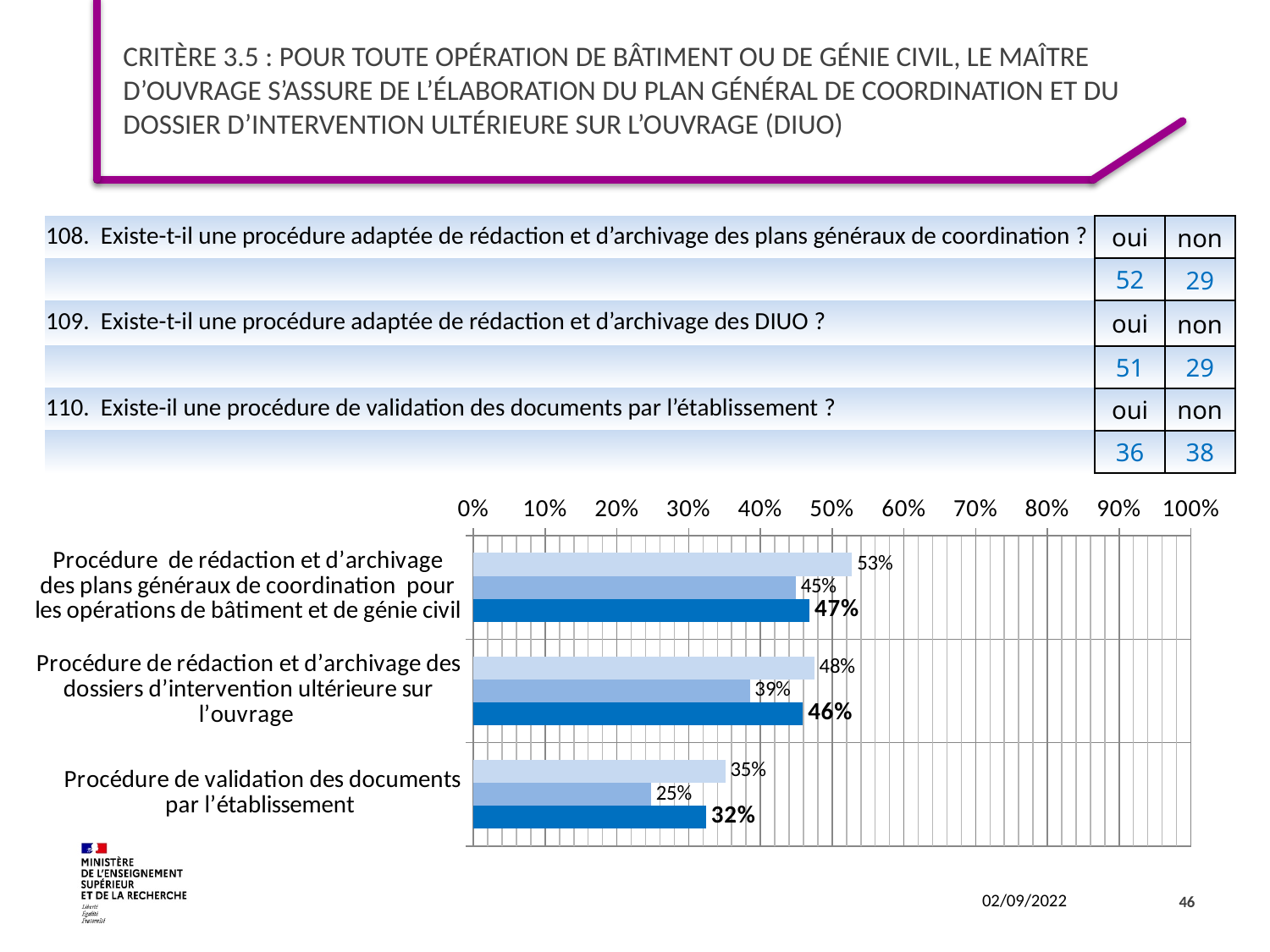
How many categories are shown on the chart? 3 For 'Procédure de rédaction et d'archivage des dossiers d'intervention ultérieure sur l'ouvrage', which is larger: the light blue (top) bar or the dark blue (bottom) bar? the light blue (top) bar What is the maximum value shown on the chart's horizontal axis? 100% What is the value of the dark blue (bottom) bar for 'Procédure de validation des documents par l'établissement'? 32% What is the value of the medium blue (middle) bar for 'Procédure de rédaction et d'archivage des dossiers d'intervention ultérieure sur l'ouvrage'? 39% Is the value of the dark blue (bottom) bar for 'Procédure de rédaction et d'archivage des plans généraux de coordination pour les opérations de bâtiment et de génie civil' greater or less than 40%? greater Which category has the lowest value for the dark blue (bottom) bar? Procédure de validation des documents par l'établissement What kind of chart is shown on the slide? bar chart Which category has the highest value for the light blue (top) bar? Procédure de rédaction et d'archivage des plans généraux de coordination pour les opérations de bâtiment et de génie civil What is the difference between the light blue (top) bar and the medium blue (middle) bar for 'Procédure de validation des documents par l'établissement'? 10% How many bars are plotted for each category on the chart? 3 What is the value of the light blue (top) bar for 'Procédure de rédaction et d'archivage des plans généraux de coordination pour les opérations de bâtiment et de génie civil'? 53%